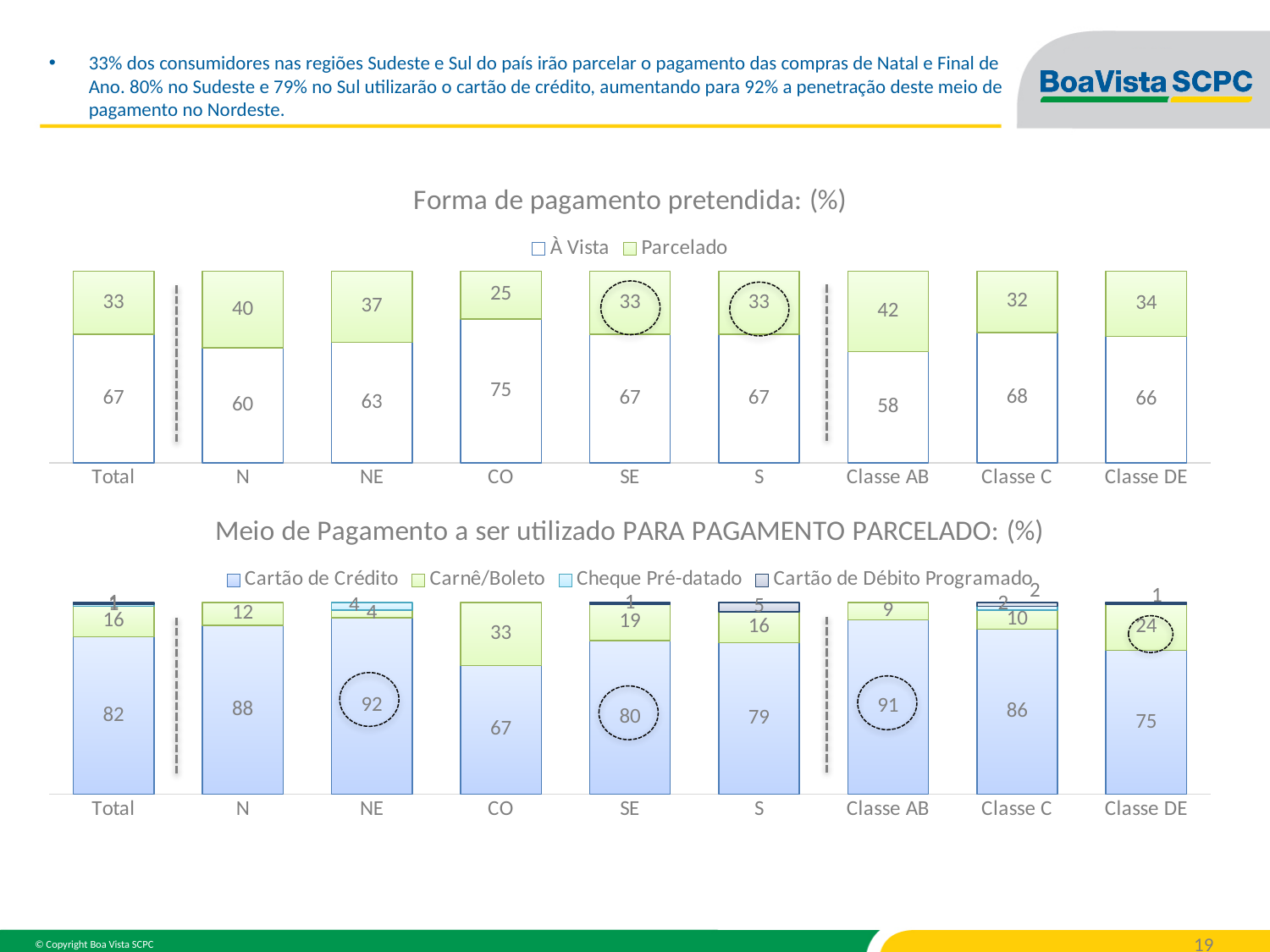
In the chart 'Meio de Pagamento a ser utilizado PARA PAGAMENTO PARCELADO: (%)', is the Cartão de Crédito value larger for N or for Classe C? N In the chart 'Meio de Pagamento a ser utilizado PARA PAGAMENTO PARCELADO: (%)', what is the Carnê/Boleto value for CO? 33 In the chart 'Forma de pagamento pretendida: (%)', what is the À Vista value for CO? 75 In the chart 'Forma de pagamento pretendida: (%)', what is the Parcelado value for Classe AB? 42 In the chart 'Meio de Pagamento a ser utilizado PARA PAGAMENTO PARCELADO: (%)', what is the Cartão de Crédito value for NE? 92 How many categories are shown on the x axis of the chart 'Forma de pagamento pretendida: (%)'? 9 In the chart 'Forma de pagamento pretendida: (%)', how many series does the legend list? 2 In the chart 'Meio de Pagamento a ser utilizado PARA PAGAMENTO PARCELADO: (%)', which category has the lowest Cartão de Crédito value? CO In the chart 'Meio de Pagamento a ser utilizado PARA PAGAMENTO PARCELADO: (%)', how many series does the legend list? 4 In the chart 'Forma de pagamento pretendida: (%)', what is the difference between the À Vista values for CO and Classe AB? 17 In the chart 'Forma de pagamento pretendida: (%)', which category has the highest Parcelado value? Classe AB In the chart 'Forma de pagamento pretendida: (%)', which category has the lowest Parcelado value? CO